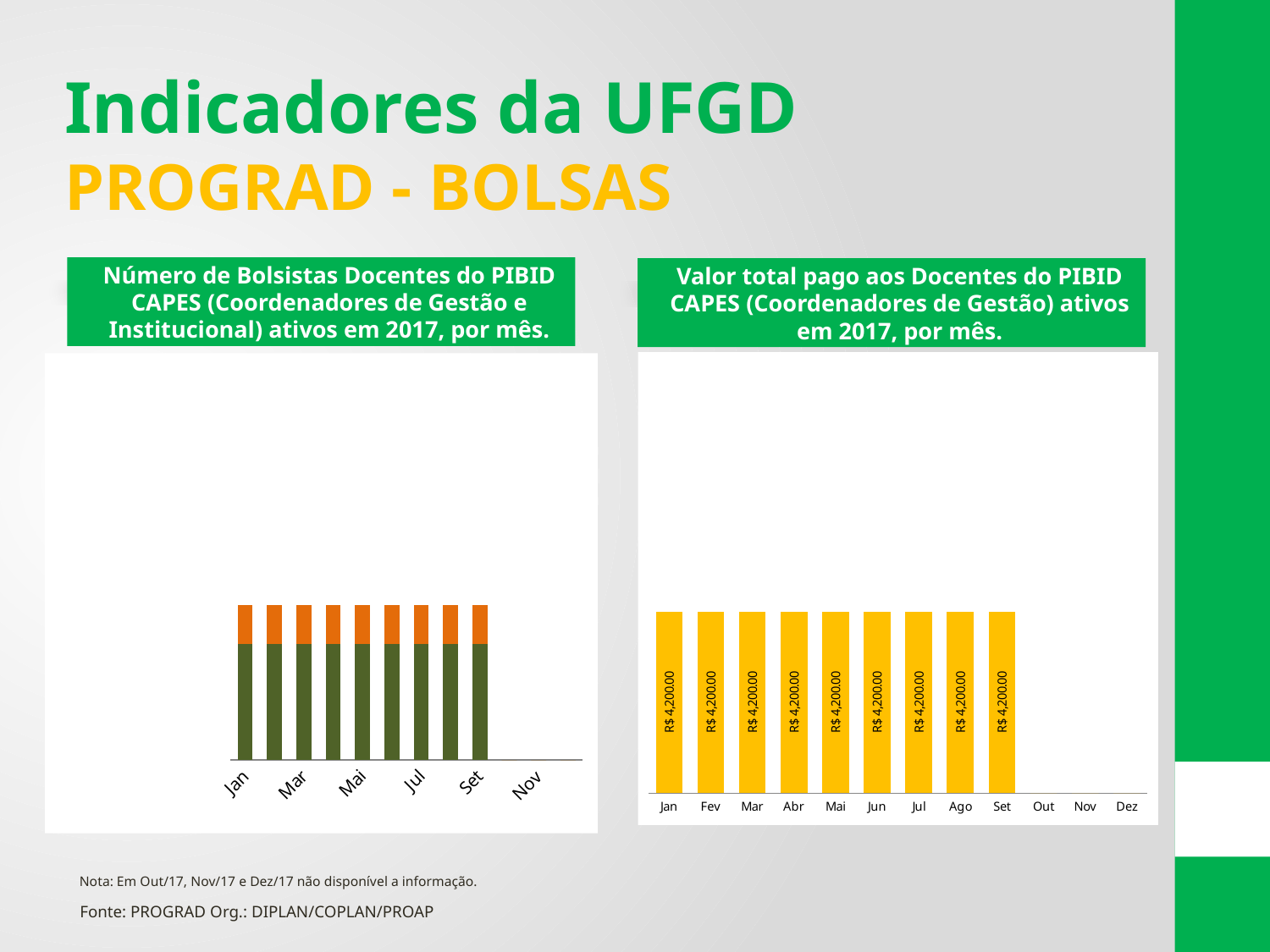
In the chart 'Valor total pago aos Docentes do PIBID CAPES (Coordenadores de Gestão) ativos em 2017, por mês', which months have no bar plotted? Out, Nov, Dez In the chart 'Valor total pago aos Docentes do PIBID CAPES (Coordenadores de Gestão) ativos em 2017, por mês', how many months have a bar plotted? 9 In the chart 'Valor total pago aos Docentes do PIBID CAPES (Coordenadores de Gestão) ativos em 2017, por mês', do the values rise, fall or stay the same from Jan to Set? stay the same In the chart 'Valor total pago aos Docentes do PIBID CAPES (Coordenadores de Gestão) ativos em 2017, por mês', what is the difference between the values for Jan and Ago? R$ 0.00 In the chart 'Valor total pago aos Docentes do PIBID CAPES (Coordenadores de Gestão) ativos em 2017, por mês', what is the value for Set? R$ 4,200.00 In the chart 'Valor total pago aos Docentes do PIBID CAPES (Coordenadores de Gestão) ativos em 2017, por mês', what is the value for Jan? R$ 4,200.00 In the chart 'Valor total pago aos Docentes do PIBID CAPES (Coordenadores de Gestão) ativos em 2017, por mês', how many months are labelled on the x axis? 12 In the chart 'Valor total pago aos Docentes do PIBID CAPES (Coordenadores de Gestão) ativos em 2017, por mês', what is the value for Mai? R$ 4,200.00 What kind of chart is the chart on the left of the slide, 'Número de Bolsistas Docentes do PIBID CAPES'? stacked bar chart In the chart on the left, 'Número de Bolsistas Docentes do PIBID CAPES', how many months have bars plotted? 9 What kind of chart is the chart on the right of the slide? bar chart What colour are the bars in the chart on the right of the slide? yellow